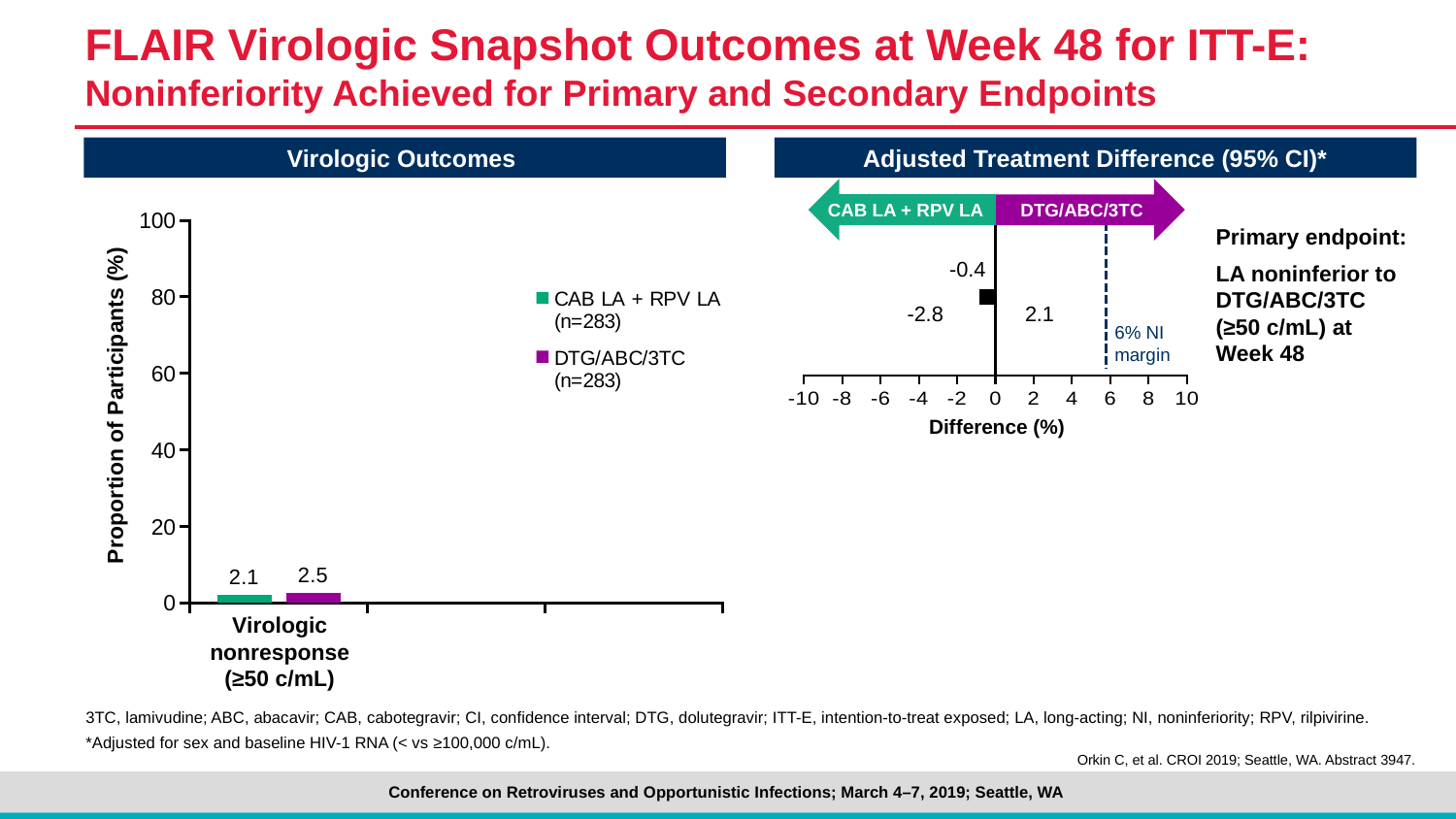
In the Virologic Outcomes chart, what is the value for CAB LA + RPV LA for virologic nonresponse (≥50 c/mL)? 2.1 In the Virologic Outcomes chart, what is the value for DTG/ABC/3TC for virologic nonresponse (≥50 c/mL)? 2.5 In the Adjusted Treatment Difference chart, what is the adjusted treatment difference point estimate? -0.4 In the Adjusted Treatment Difference chart, what noninferiority margin is marked by the dashed line? 6% In the Adjusted Treatment Difference chart, what is the lower bound of the 95% CI? -2.8 In the Virologic Outcomes chart, how many series does the legend list? 2 In the Virologic Outcomes chart, which series has the higher virologic nonresponse value? DTG/ABC/3TC In the Virologic Outcomes chart, is the value for CAB LA + RPV LA greater or less than 20? less In the Virologic Outcomes chart, what is the label of the y axis? Proportion of Participants (%) In the Adjusted Treatment Difference chart, what is the upper bound of the 95% CI? 2.1 In the Virologic Outcomes chart, what is the difference between the DTG/ABC/3TC and CAB LA + RPV LA virologic nonresponse values? 0.4 What kind of chart is the Virologic Outcomes chart? Bar chart